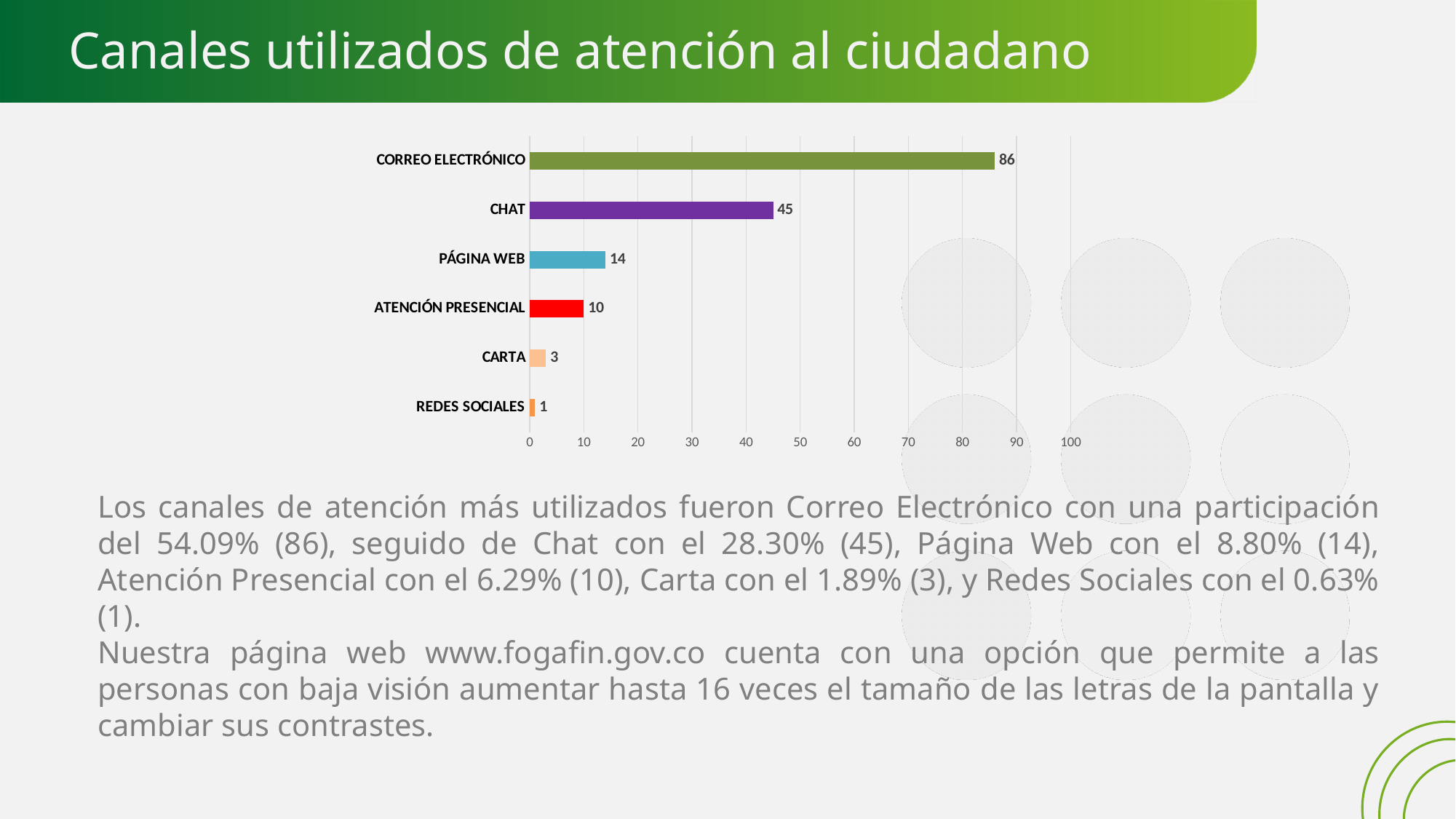
How many categories are shown in the chart? 6 What is the value for ATENCIÓN PRESENCIAL? 10 Which category has the highest value? CORREO ELECTRÓNICO Which is larger, the value for PÁGINA WEB or the value for ATENCIÓN PRESENCIAL? PÁGINA WEB What is the value for PÁGINA WEB? 14 What is the total of the values for CARTA and REDES SOCIALES? 4 What is the value for CHAT? 45 What kind of chart is shown on the slide? Bar chart Which category has the lowest value? REDES SOCIALES What is the difference between the values for CORREO ELECTRÓNICO and CHAT? 41 What is the value for CARTA? 3 What is the value for CORREO ELECTRÓNICO? 86